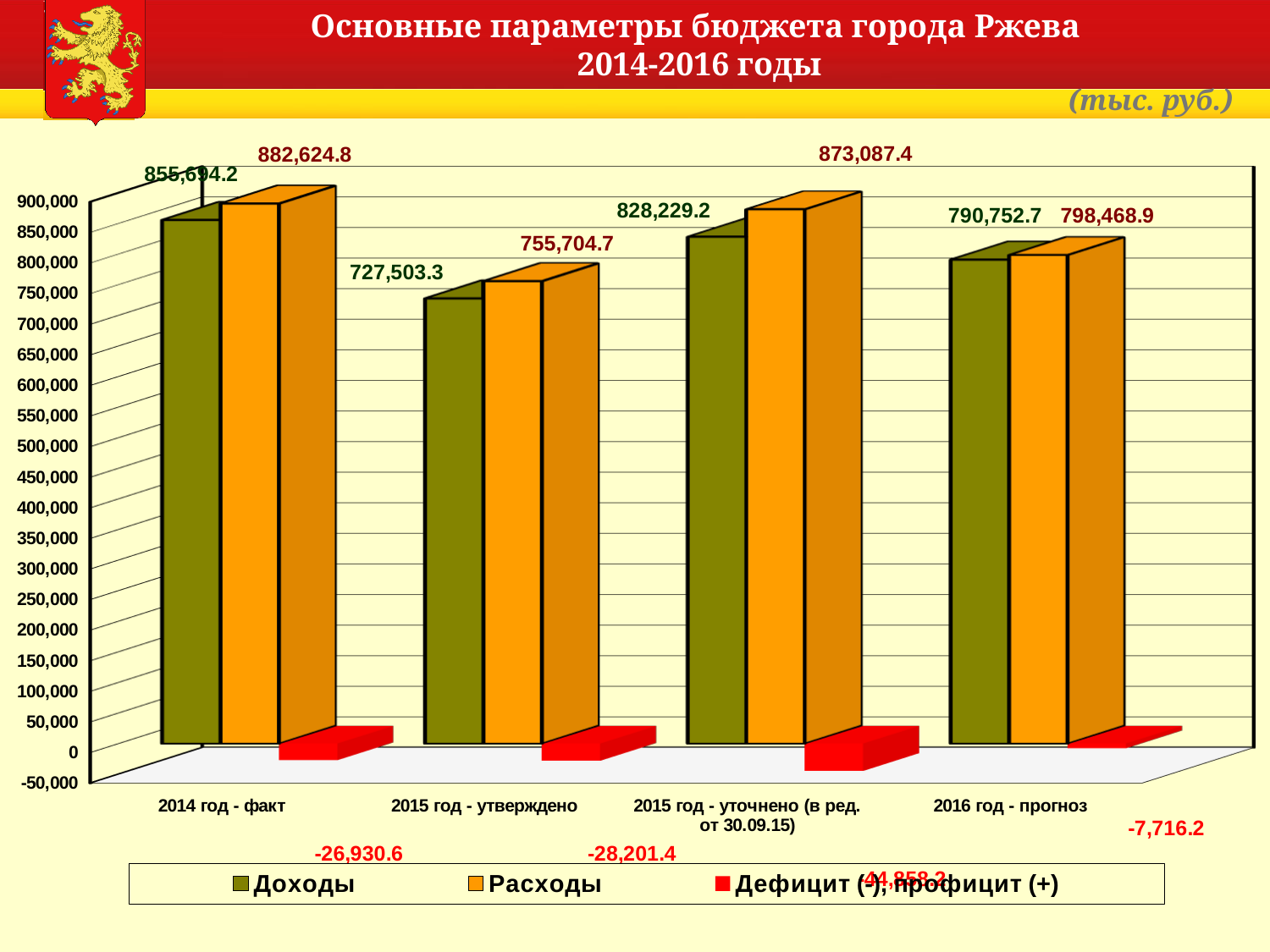
What is the value of Доходы for 2015 год - уточнено (в ред. от 30.09.15)? 828,229.2 What is the value of Расходы for 2015 год - утверждено? 755,704.7 What is the value of Доходы for 2014 год - факт? 855,694.2 Which category has the lowest value of Доходы? 2015 год - утверждено How many categories are shown on the x axis? 4 What kind of chart is shown on the slide? Bar chart Which category has the highest value of Расходы? 2014 год - факт What is the difference between Расходы and Доходы for 2014 год - факт? 26,930.6 What is the value of Дефицит (-), профицит (+) for 2016 год - прогноз? -7,716.2 How many series does the legend list? 3 Which is larger for 2016 год - прогноз: Доходы or Расходы? Расходы Is the value of Доходы for 2015 год - утверждено greater or less than 750,000? less